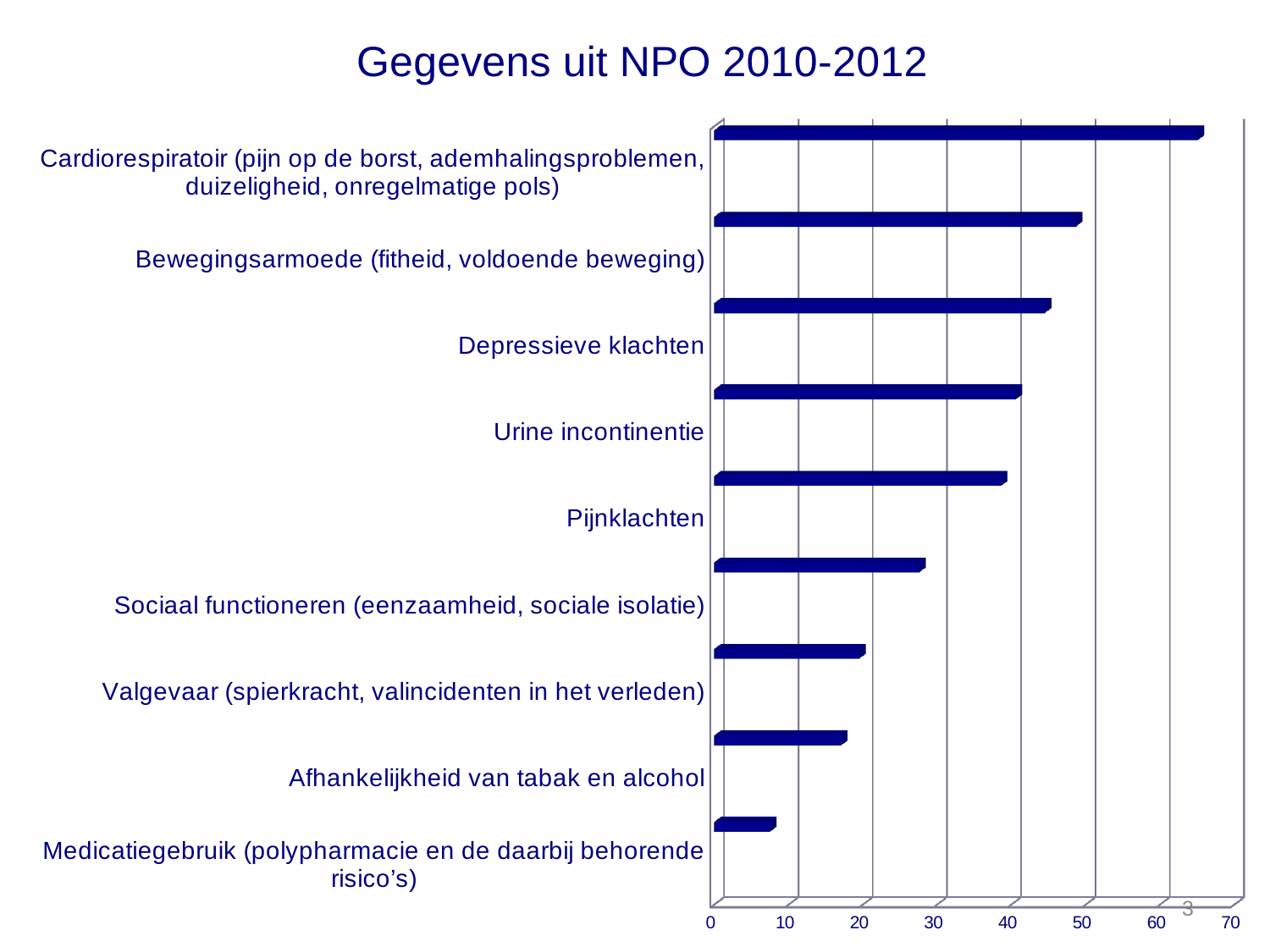
Is the value for Depressieve klachten greater or less than 40? greater Is the value for Medicatiegebruik greater or less than 10? less What is the title of the chart? Gegevens uit NPO 2010-2012 Is the value for Afhankelijkheid van tabak en alcohol greater or less than 20? less How many categories are plotted in the chart? 9 What type of chart is shown on the slide? bar chart Which is larger, the value for Bewegingsarmoede or the value for Valgevaar? Bewegingsarmoede Which category has the highest value? Cardiorespiratoir (pijn op de borst, ademhalingsproblemen, duizeligheid, onregelmatige pols) Which category has the lowest value? Medicatiegebruik (polypharmacie en de daarbij behorende risico's) Which is larger, the value for Depressieve klachten or the value for Sociaal functioneren? Depressieve klachten